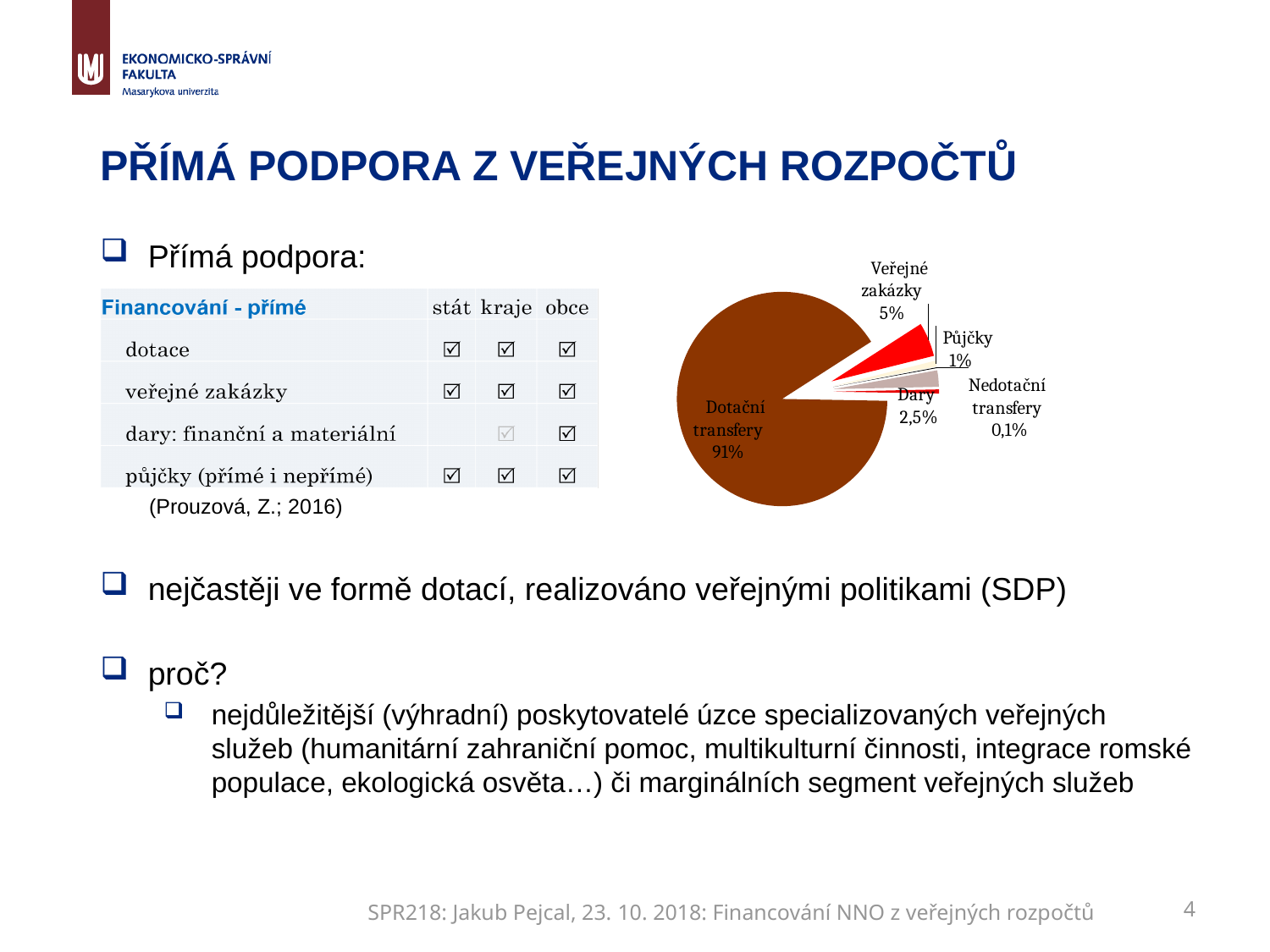
Which slice of the pie chart is the largest? Dotační transfery What colour is the Dotační transfery slice of the pie chart? brown How many slices does the pie chart have? 6 What kind of chart is shown on the slide? pie chart What share of the pie does Veřejné zakázky have? 5% What share of the pie does Dary have? 2,5% What share of the pie does Půjčky have? 1% What is the difference in percentage points between Veřejné zakázky and Dary? 2,5% Which is larger in the pie chart, Dary or Půjčky? Dary Which slice of the pie chart is the smallest? Nedotační transfery